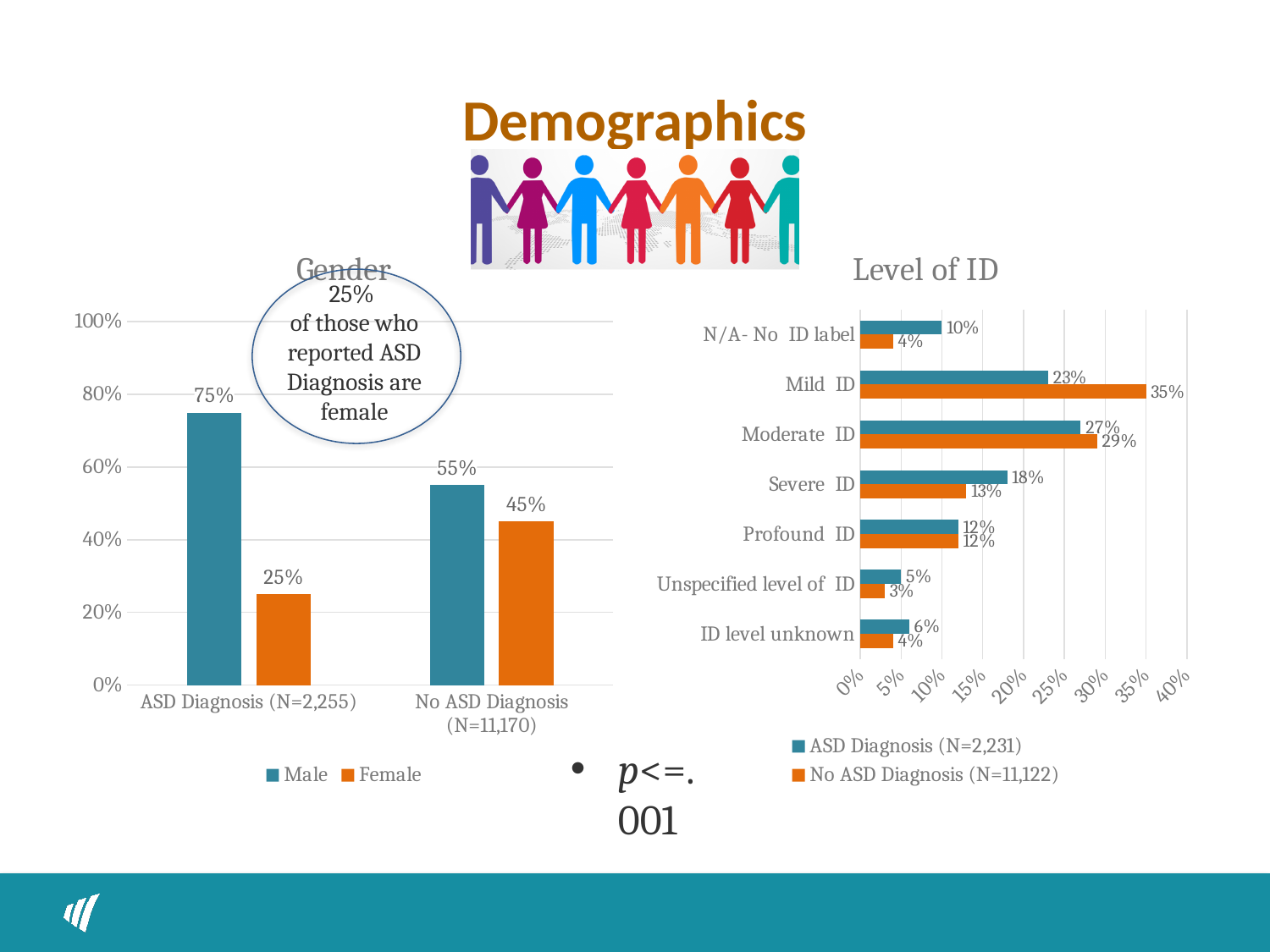
In the Level of ID chart, what is the difference between the No ASD Diagnosis and ASD Diagnosis values for Mild ID? 12% In the Gender chart, what percentage of the ASD Diagnosis group is Male? 75% In the Level of ID chart, how many categories are shown on the vertical axis? 7 In the Gender chart, what is the difference between the Male and Female percentages for the ASD Diagnosis group? 50% In the Level of ID chart, which category has the highest value for the ASD Diagnosis series? Moderate ID In the Level of ID chart, what is the value for Severe ID in the ASD Diagnosis series? 18% In the Gender chart, what percentage of the No ASD Diagnosis group is Female? 45% In the Gender chart, what kind of chart is shown? Bar chart In the Gender chart, how many series does the legend list? 2 In the Level of ID chart, what is the value for Mild ID in the No ASD Diagnosis series? 35% In the Level of ID chart, which series has the larger value for N/A- No ID label? ASD Diagnosis (N=2,231) In the Level of ID chart, which category has the lowest value for the No ASD Diagnosis series? Unspecified level of ID